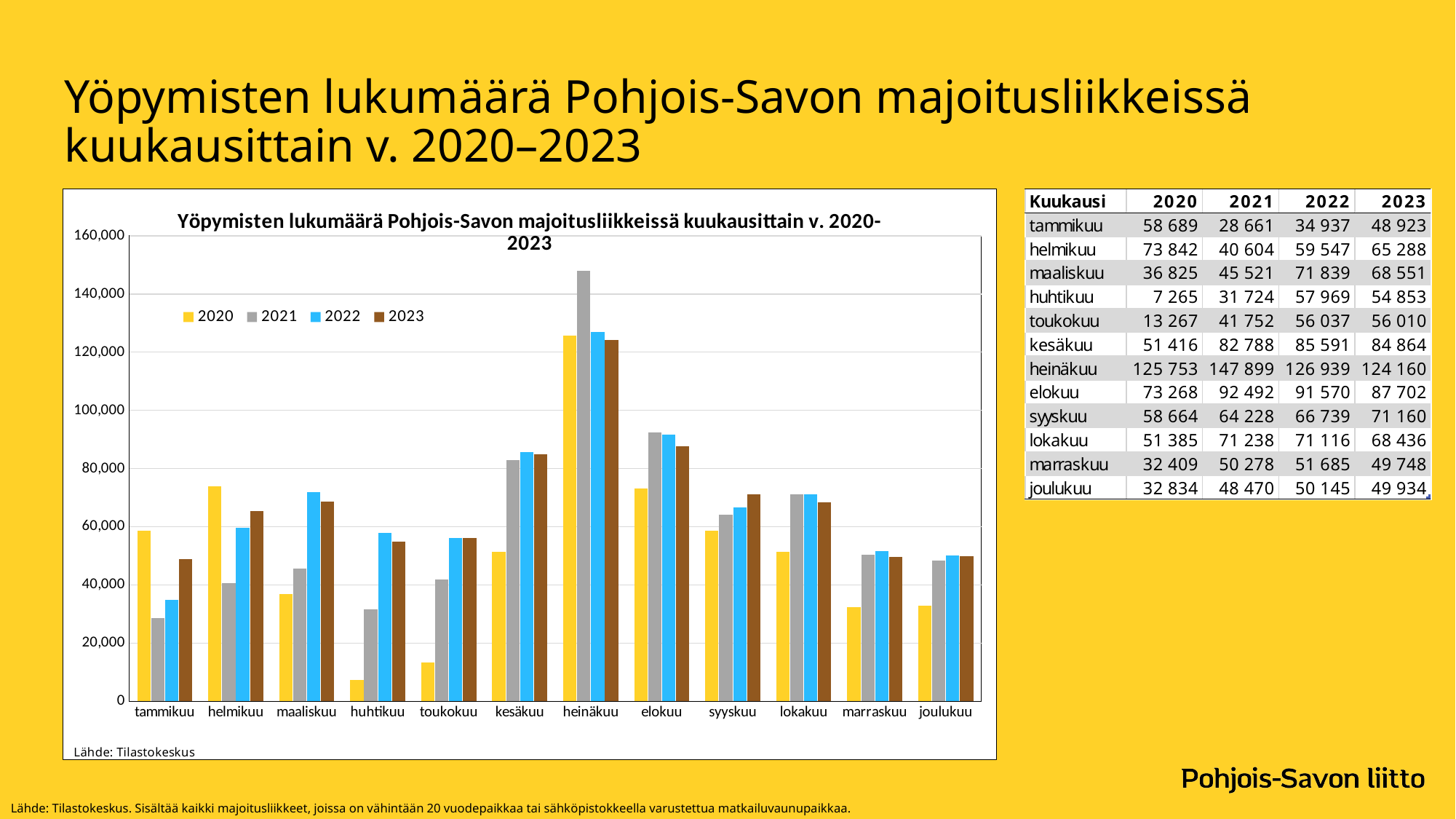
How many series does the chart legend list? 4 Which month has the highest value for 2021? heinäkuu According to the table, what is the number of overnight stays in heinäkuu in 2021? 147 899 Which month has the lowest value for 2020? huhtikuu How many months (categories) are shown on the x axis of the chart? 12 What colour represents the 2022 series in the chart? blue Using the table values, what is the difference between the 2021 and 2020 values for heinäkuu? 22 146 Is the value for huhtikuu in 2020 greater or less than 20,000? less Is the value for elokuu in 2021 greater or less than 80,000? greater What kind of chart is shown on the slide? bar chart According to the table, what is the value for tammikuu in 2020? 58 689 For helmikuu, which year has the larger value, 2020 or 2021? 2020